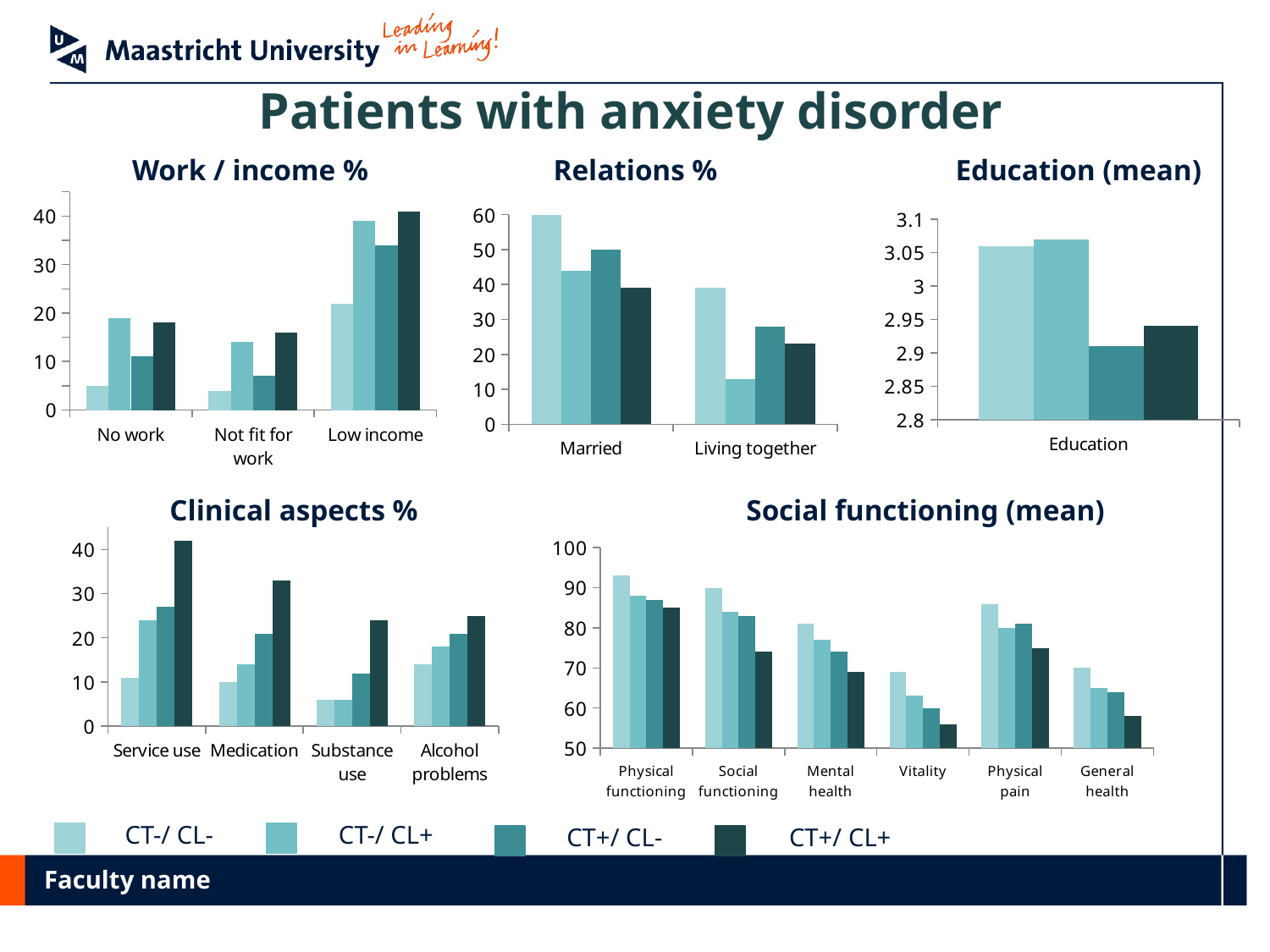
What kind of chart is the 'Work / income %' chart? bar chart In the 'Clinical aspects %' chart, which series has the highest value for Service use? CT+/ CL+ In the 'Education (mean)' chart, which is larger: the CT-/ CL+ value or the CT+/ CL- value? CT-/ CL+ How many categories are shown on the x axis of the 'Clinical aspects %' chart? 4 What is the main title of the slide above the charts? Patients with anxiety disorder In the 'Work / income %' chart, is the CT-/ CL- value for Low income greater or less than 30? less In the 'Relations %' chart, is the CT-/ CL+ value for Living together greater or less than 20? less How many series does the shared legend at the bottom of the slide list? 4 How many categories are shown on the x axis of the 'Social functioning (mean)' chart? 6 In the 'Relations %' chart, which category has the higher CT+/ CL- value, Married or Living together? Married In the 'Relations %' chart, is the CT-/ CL- value for Married greater or less than 50? greater In the 'Social functioning (mean)' chart, which series has the lowest value for Vitality? CT+/ CL+